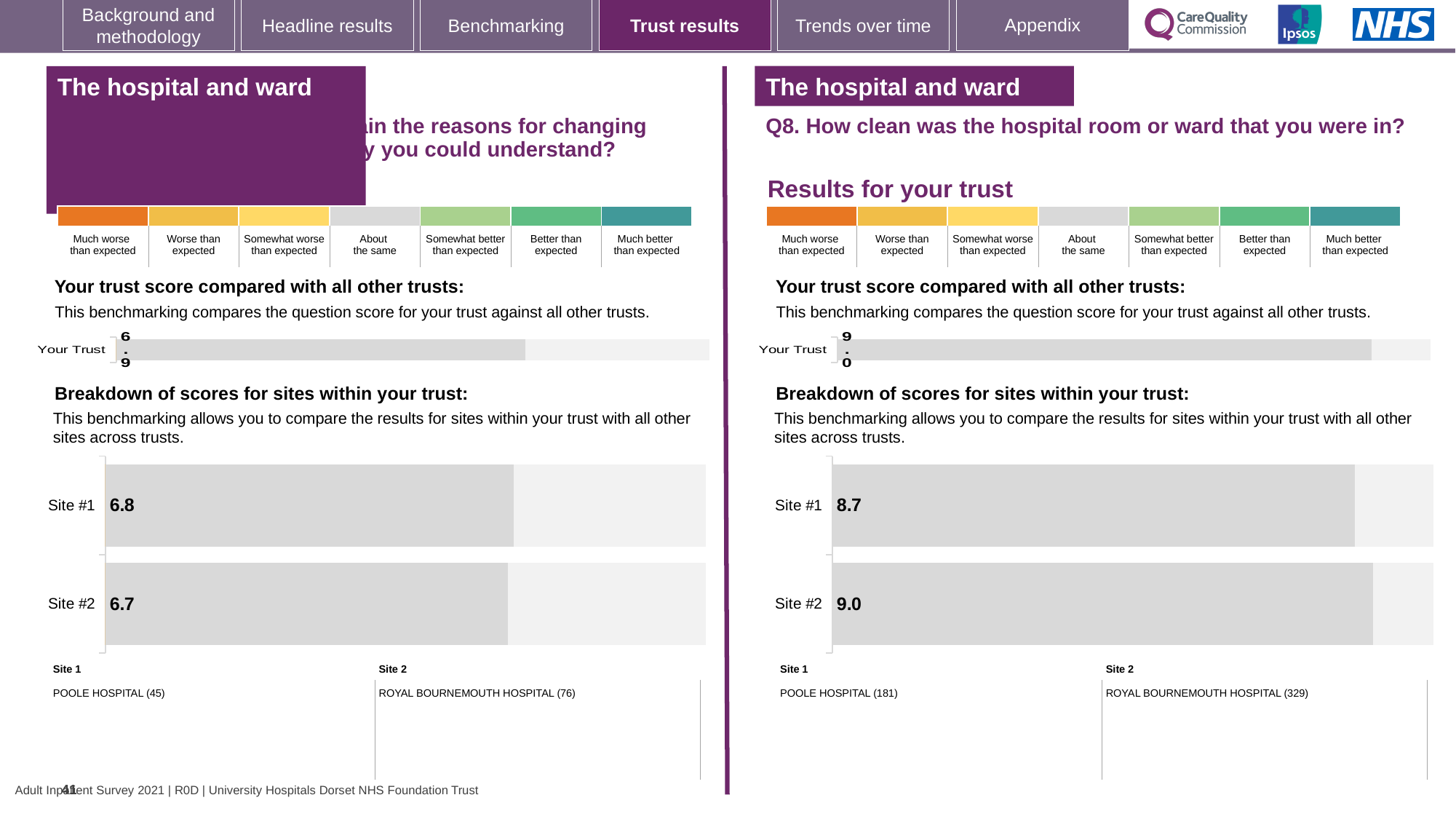
On the right-hand chart for Q8, which site has the higher score, Site #1 or Site #2? Site #2 On the right-hand chart for Q8, what is the 'Your Trust' score? 9.0 On the left-hand chart, what is the 'Your Trust' score? 6.9 What type of chart is used for the site breakdown on the right-hand side for Q8? Bar chart On the left-hand site breakdown chart, what is the difference between the Site #1 and Site #2 scores? 0.1 On the right-hand chart for Q8, what is the score for Site #2? 9.0 How many sites are shown in the site breakdown chart on the right-hand side for Q8? 2 On the left-hand site breakdown chart, what is the score for Site #2? 6.7 On the right-hand chart for Q8 (How clean was the hospital room or ward), what is the score for Site #1? 8.7 On the right-hand side for Q8, which hospital is listed as Site 2? ROYAL BOURNEMOUTH HOSPITAL (329) On the left-hand site breakdown chart, what is the score for Site #1? 6.8 On the right-hand chart for Q8, what is the difference between the Site #2 and Site #1 scores? 0.3